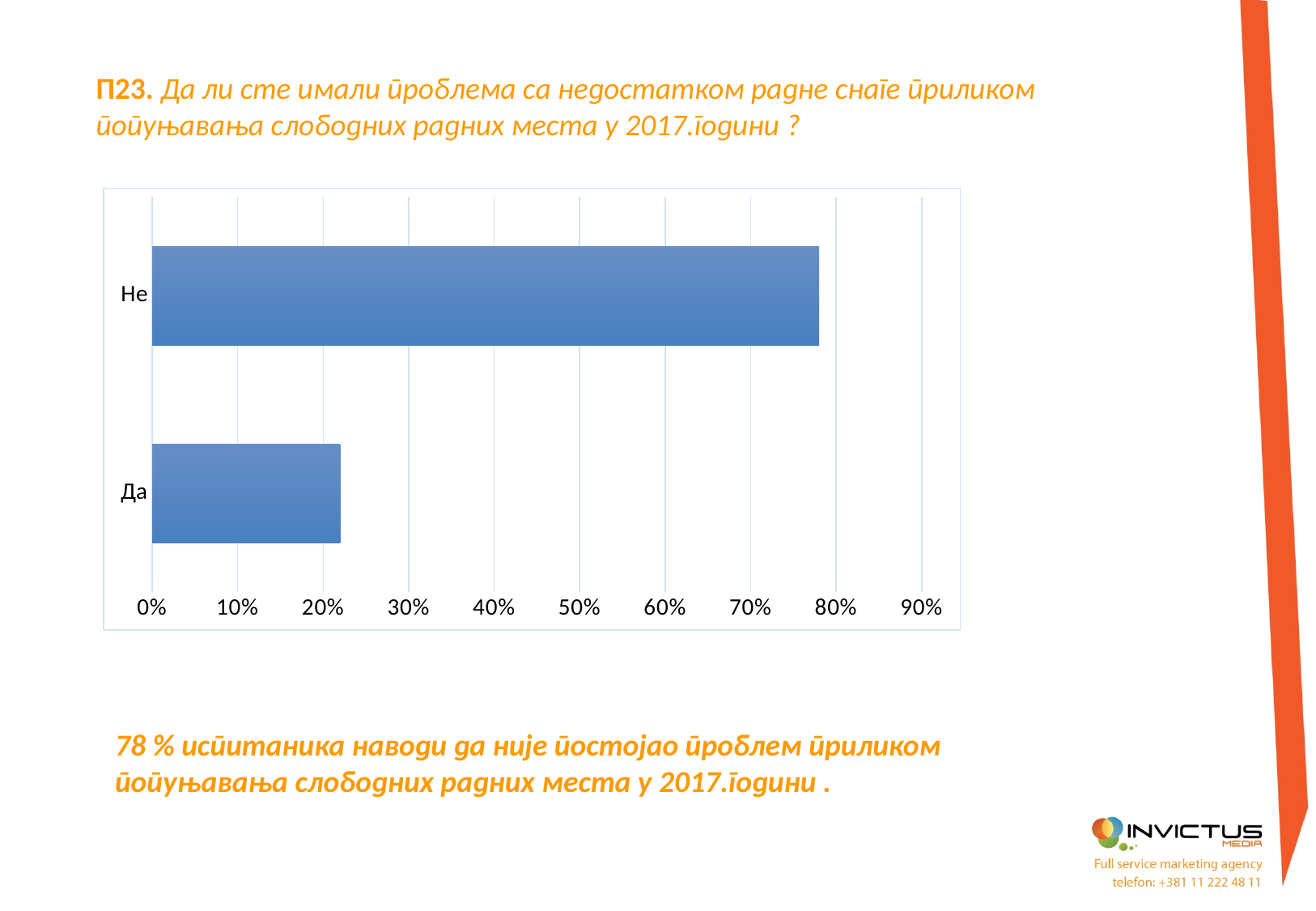
What colour are the bars in the chart? blue According to the slide, what percentage of respondents answered Не? 78 % Is the value for Не greater or less than 80%? less Which is larger, the value for Не or the value for Да? Не What is the highest tick label shown on the horizontal axis of the chart? 90% Which category has the highest value in the chart? Не How many categories are plotted in the chart? 2 Is the value for Не greater or less than 70%? greater What kind of chart is shown on the slide? bar chart Is the value for Да greater or less than 30%? less Which category has the lowest value in the chart? Да